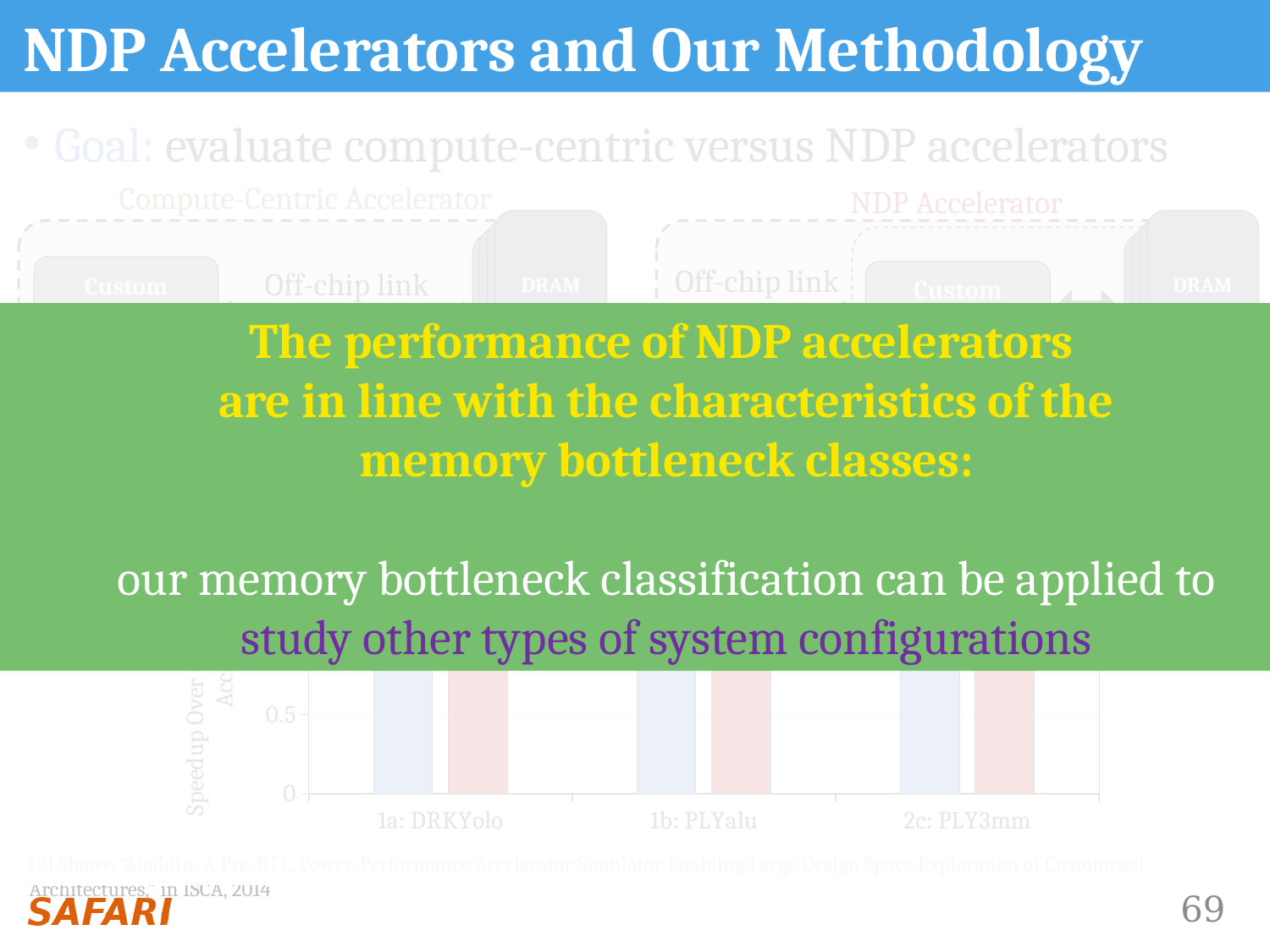
What is the label of the last category on the x axis of the chart? 2c: PLY3mm Are the bars for 1a: DRKYolo greater or less than 0.5? greater Are the bars for 1b: PLYalu greater or less than 0.5? greater What is the label of the first category on the x axis of the chart? 1a: DRKYolo What kind of chart is shown at the bottom of the slide? bar chart Are the bars for 2c: PLY3mm greater or less than 0.5? greater How many categories are shown on the x axis of the chart? 3 How many bars are drawn for each category in the chart? 2